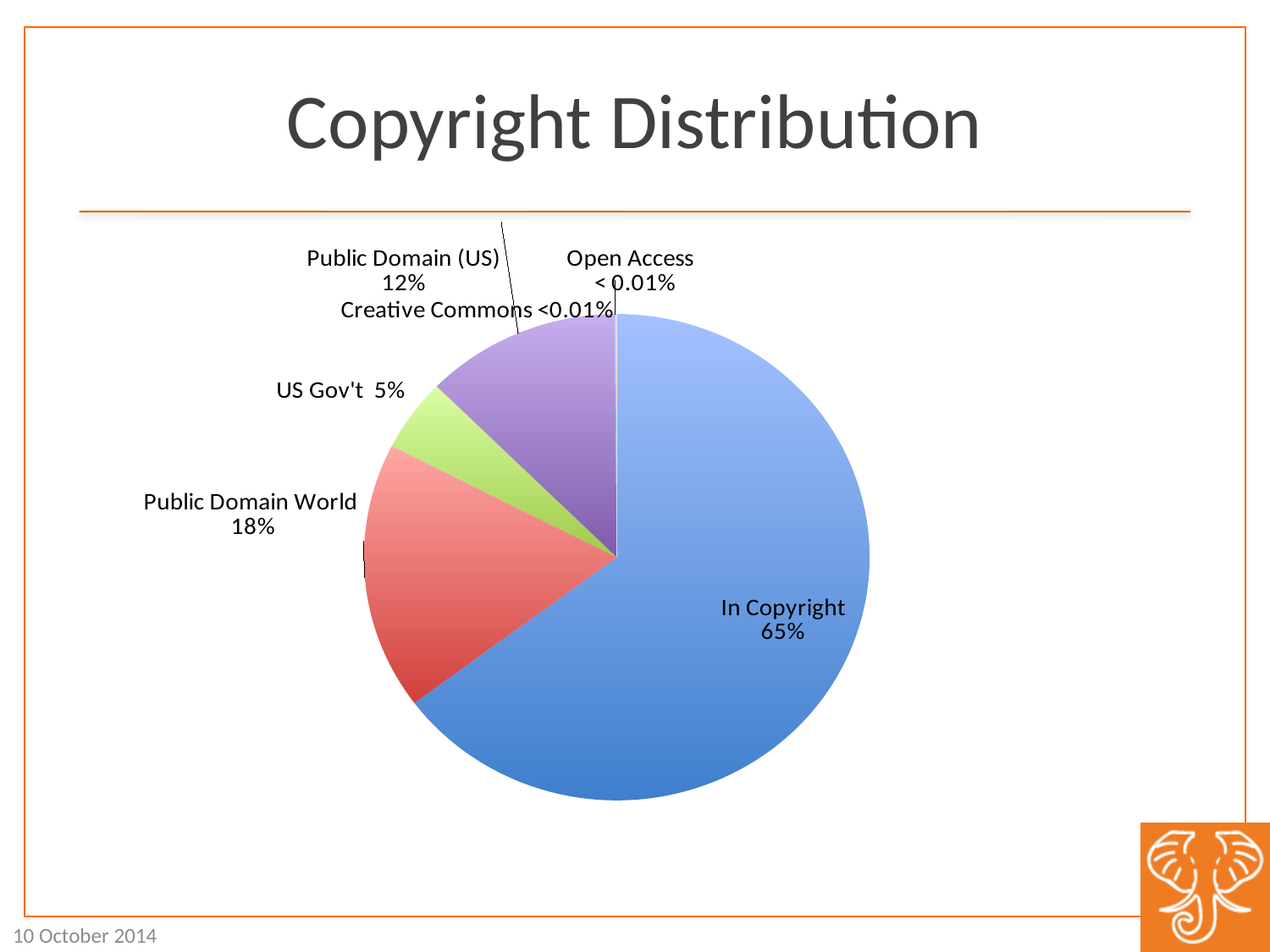
Which is larger, Public Domain World or Public Domain (US)? Public Domain World What is the value for Public Domain (US)? 12% What kind of chart is shown on the slide? pie chart What is the title of the chart? Copyright Distribution What is the difference in percentage points between Public Domain (US) and US Gov't? 7 What share of the pie is In Copyright? 65% What is the value for US Gov't? 5% How many categories are shown in the pie chart? 6 What is the value for Public Domain World? 18% What is the difference in percentage points between In Copyright and Public Domain World? 47 Which category has the largest slice of the pie? In Copyright What value is shown for Creative Commons? <0.01%